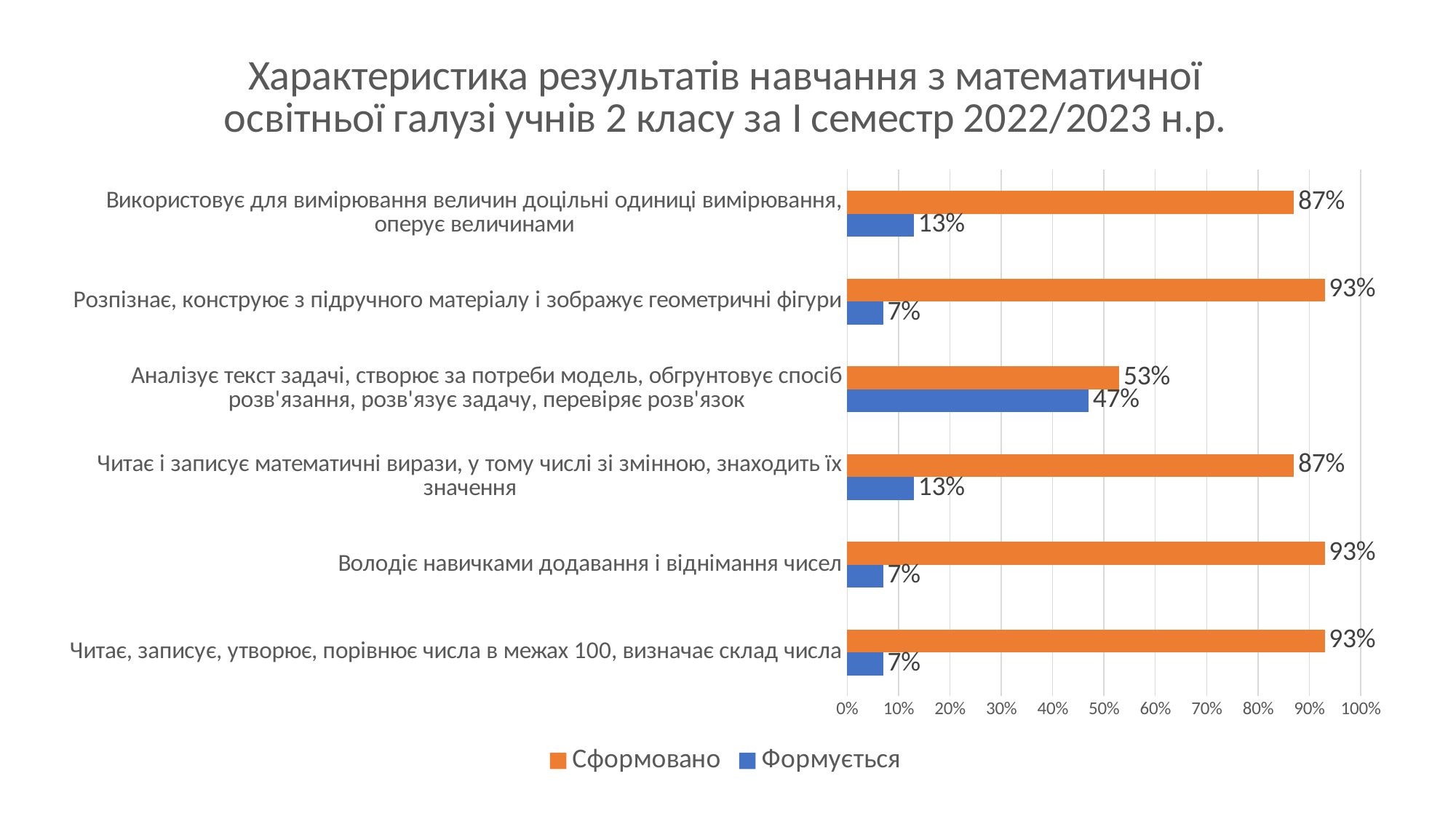
Which is larger: the "Сформовано" value for "Читає і записує математичні вирази, у тому числі зі змінною, знаходить їх значення" or for "Володіє навичками додавання і віднімання чисел"? Володіє навичками додавання і віднімання чисел Which category has the highest "Формується" value? Аналізує текст задачі, створює за потреби модель, обгрунтовує спосіб розв'язання, розв'язує задачу, перевіряє розв'язок Which category has the lowest "Сформовано" value? Аналізує текст задачі, створює за потреби модель, обгрунтовує спосіб розв'язання, розв'язує задачу, перевіряє розв'язок What kind of chart is shown on the slide? bar chart What is the difference between the "Сформовано" and "Формується" values for "Аналізує текст задачі, створює за потреби модель, обгрунтовує спосіб розв'язання, розв'язує задачу, перевіряє розв'язок"? 6% How many series does the legend list? 2 What is the "Сформовано" value for "Аналізує текст задачі, створює за потреби модель, обгрунтовує спосіб розв'язання, розв'язує задачу, перевіряє розв'язок"? 53% Is the "Сформовано" value for "Розпізнає, конструює з підручного матеріалу і зображує геометричні фігури" greater or less than 90%? greater What is the "Формується" value for "Володіє навичками додавання і віднімання чисел"? 7% How many categories are shown on the chart? 6 What is the "Формується" value for "Використовує для вимірювання величин доцільні одиниці вимірювання, оперує величинами"? 13% Which colour represents the "Формується" series? blue